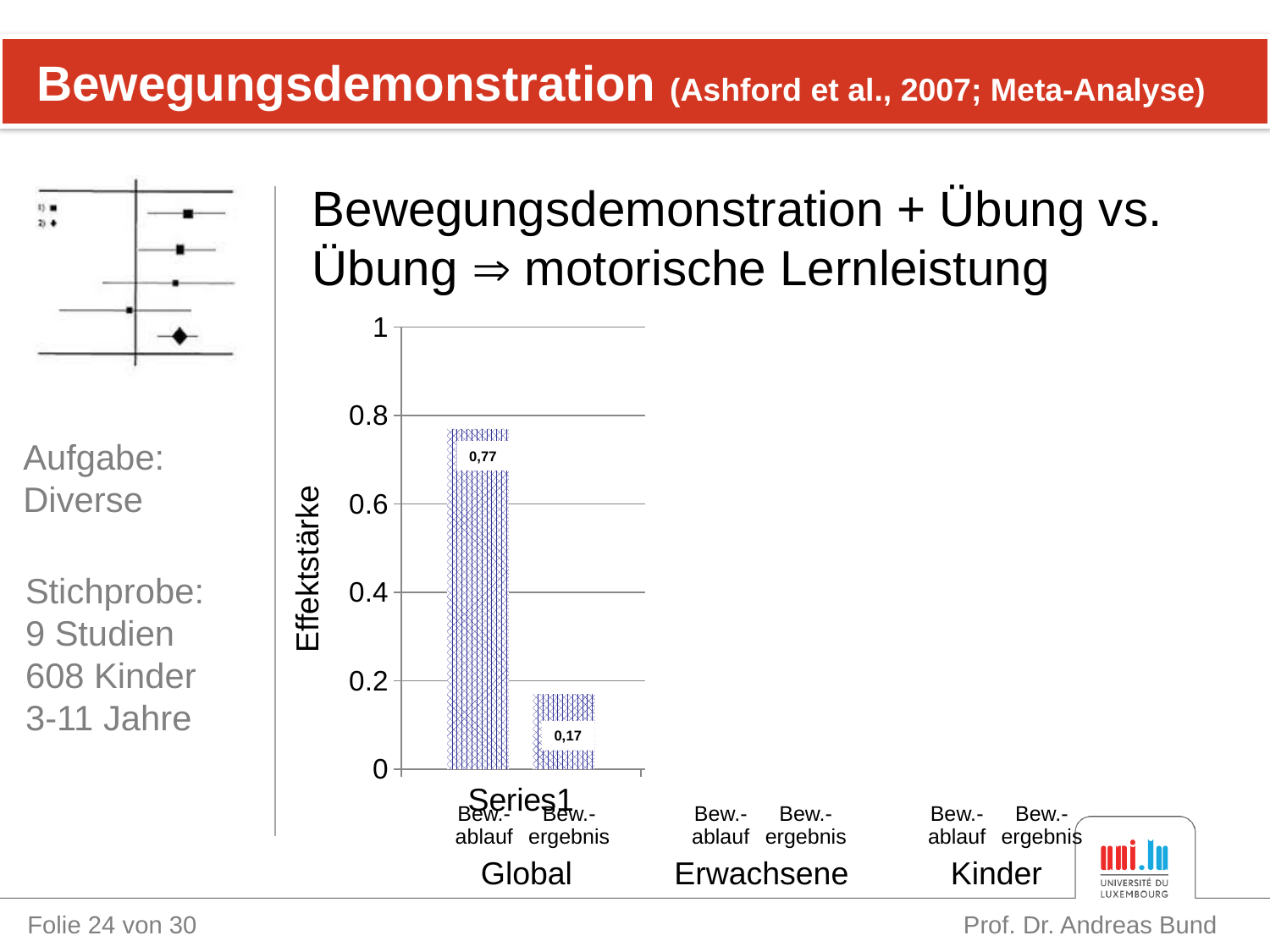
What is the difference between the Bew.-ablauf value (0,77) and the Bew.-ergebnis value (0,17)? 0,60 What is the effect size (Effektstärke) for Bew.-ergebnis in the Global group? 0,17 Do the bar values rise or fall from Bew.-ablauf to Bew.-ergebnis? fall What is the label of the y-axis of the chart? Effektstärke Which bar is higher, Bew.-ablauf or Bew.-ergebnis? Bew.-ablauf What is the maximum value shown on the y-axis of the chart? 1 What kind of chart is shown on the slide? Bar chart Is the value for Bew.-ablauf greater or less than 0.6? greater What is the effect size (Effektstärke) for Bew.-ablauf in the Global group? 0,77 How many bars are plotted in the chart? 2 Is the value for Bew.-ergebnis greater or less than 0.2? less Which bar is lower, Bew.-ablauf or Bew.-ergebnis? Bew.-ergebnis